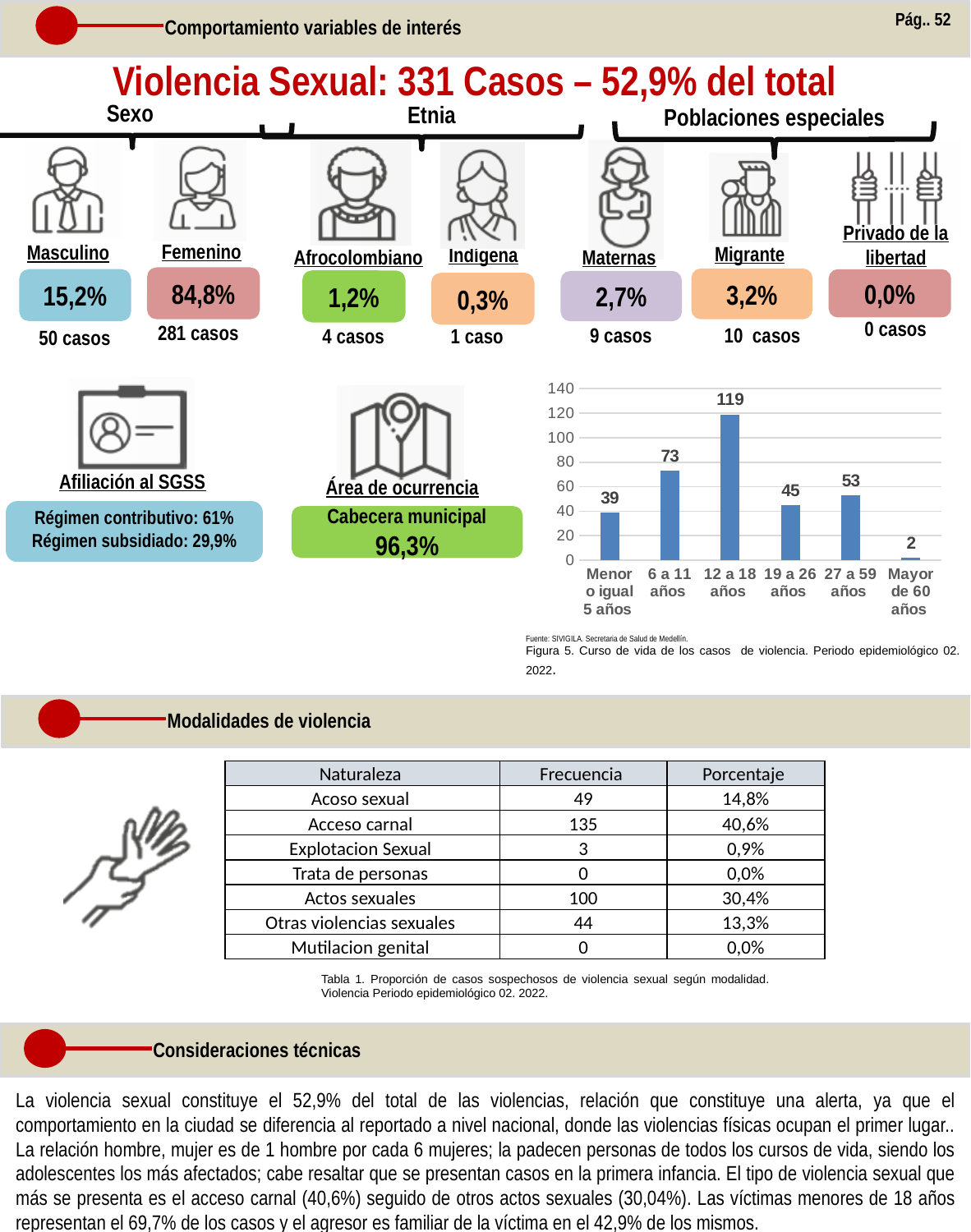
Which age group has the highest number of cases in the bar chart? 12 a 18 años What is the value for the 'Mayor de 60 años' age group in the bar chart? 2 What type of chart is used to show the cases by life course (age group)? bar chart Which is larger in the bar chart, the value for '19 a 26 años' or for '27 a 59 años'? 27 a 59 años What is the value for the '12 a 18 años' age group in the bar chart? 119 Which age group has the lowest number of cases in the bar chart? Mayor de 60 años What is the difference between the values for '12 a 18 años' and '6 a 11 años' in the bar chart? 46 What is the value for the '27 a 59 años' age group in the bar chart? 53 What is the highest value shown on the y axis of the bar chart? 140 How many age-group categories are shown on the x axis of the bar chart? 6 What is the value for the 'Menor o igual 5 años' age group in the bar chart? 39 Is the value for '6 a 11 años' in the bar chart greater or less than 60? greater